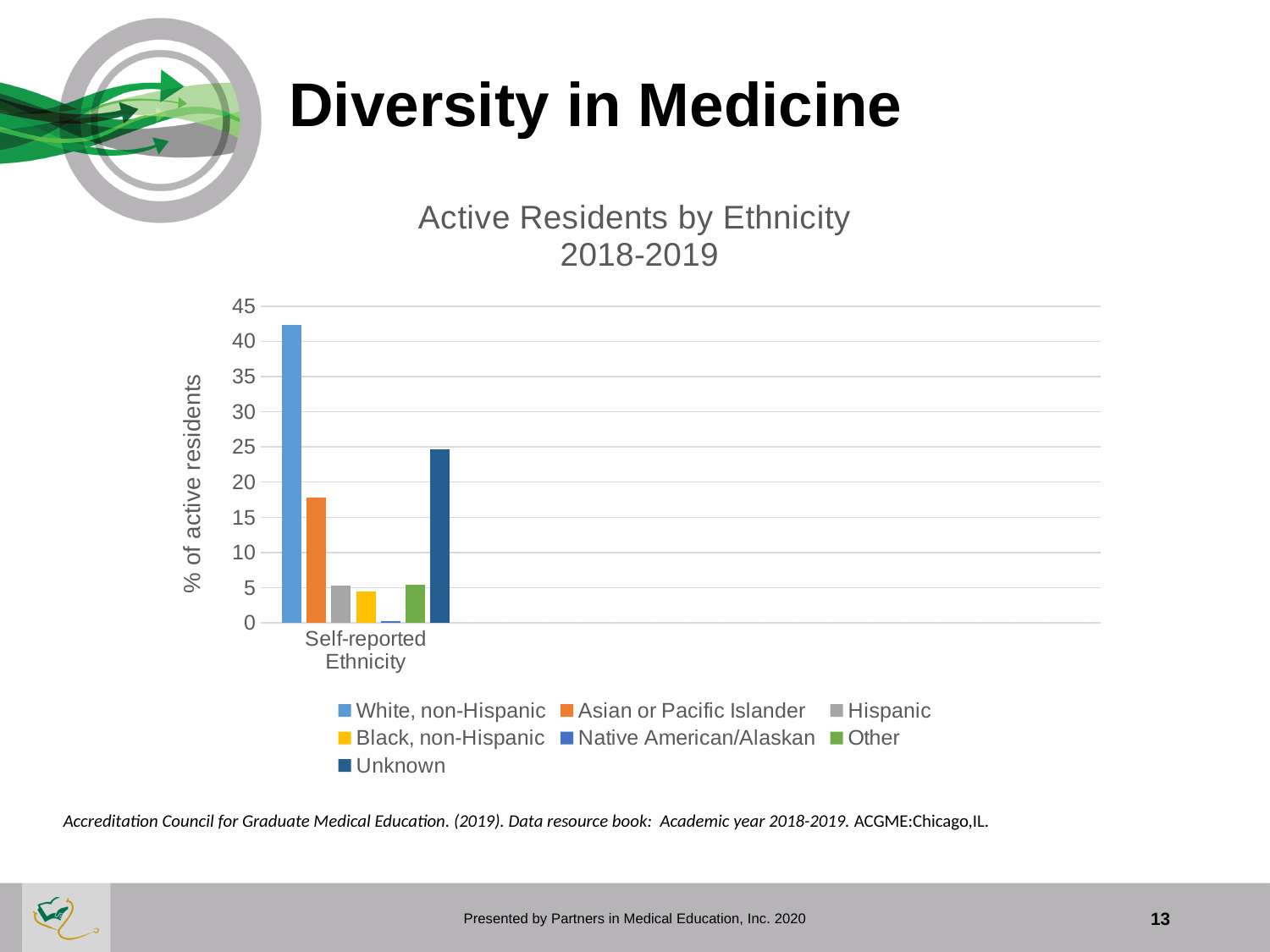
Is the value for Asian or Pacific Islander greater or less than 20? less Which ethnicity has the highest percentage of active residents? White, non-Hispanic How many series does the legend list? 7 Which is larger, the value for Unknown or the value for Asian or Pacific Islander? Unknown What type of chart is shown on the slide? bar chart Is the value for White, non-Hispanic greater or less than 40? greater Is the value for Unknown greater or less than 20? greater What is the label of the vertical axis? % of active residents Which ethnicity has the lowest percentage of active residents? Native American/Alaskan What is the title of the chart? Active Residents by Ethnicity 2018-2019